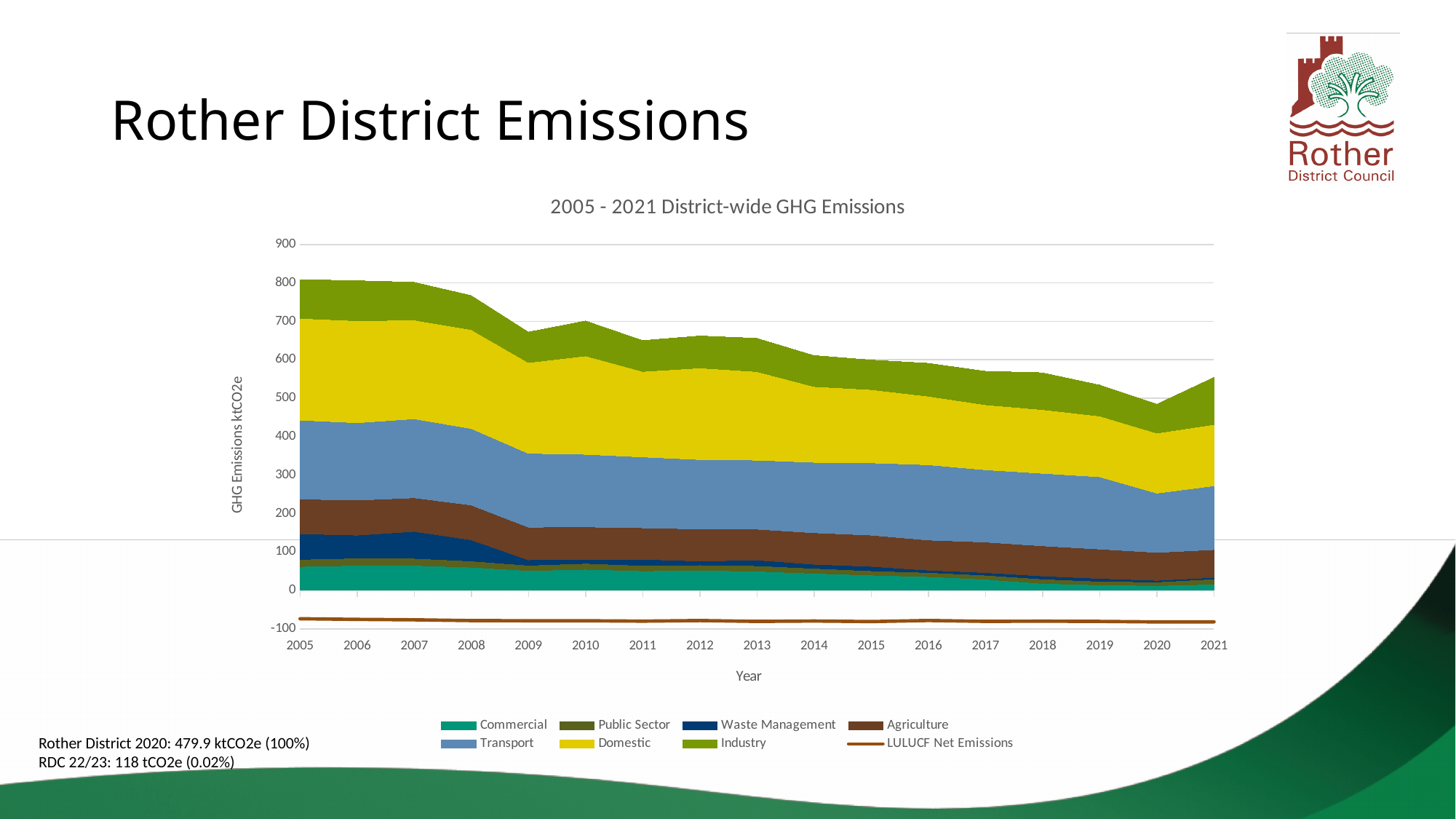
Is the total stacked emissions value for 2021 greater or less than 500? greater What is the title of the chart? 2005 - 2021 District-wide GHG Emissions Is the total stacked emissions value for 2005 greater or less than 700? greater Do the total stacked emissions generally rise or fall from 2005 to 2020? fall In which year is the total stacked emissions value lowest? 2020 Which is larger, the total stacked emissions in 2005 or in 2021? 2005 Is the total stacked emissions value for 2020 greater or less than 600? less How many series does the chart's legend list? 8 What kind of chart is shown on the slide? Stacked area chart What is the label of the vertical axis of the chart? GHG Emissions ktCO2e How many years are plotted along the x axis of the chart? 17